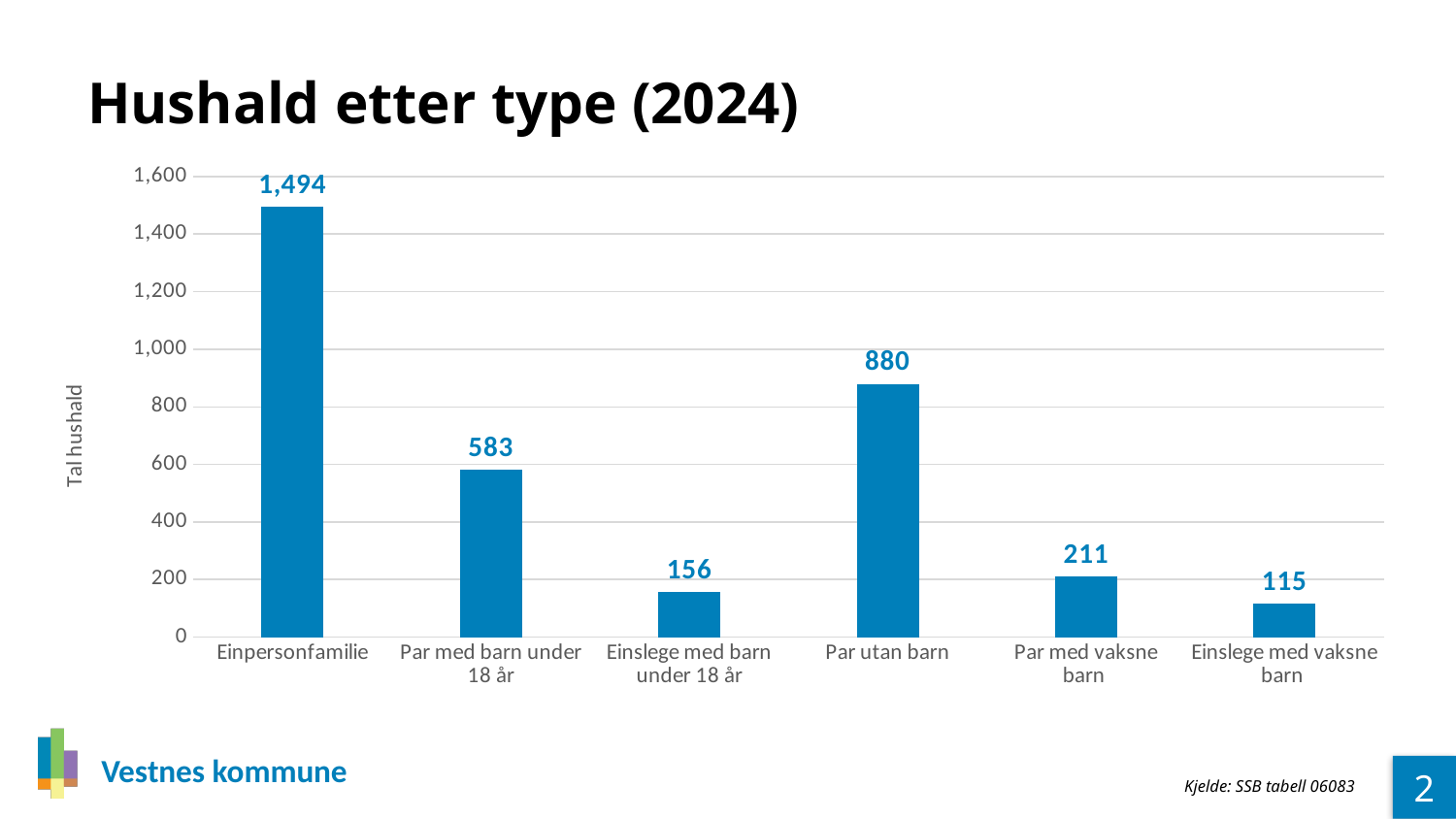
What is the value for Par utan barn? 880 Which household type has the highest value? Einpersonfamilie Which is larger, Par med vaksne barn or Einslege med barn under 18 år? Par med vaksne barn How many household types are shown on the chart? 6 What kind of chart is shown on the slide? bar chart Is the value for Par med barn under 18 år greater or less than 600? less What is the value for Einslege med vaksne barn? 115 What is the value for Einpersonfamilie? 1,494 What is the value for Einslege med barn under 18 år? 156 Which household type has the lowest value? Einslege med vaksne barn What is the difference between Par utan barn and Par med barn under 18 år? 297 What is the title of the chart? Hushald etter type (2024)